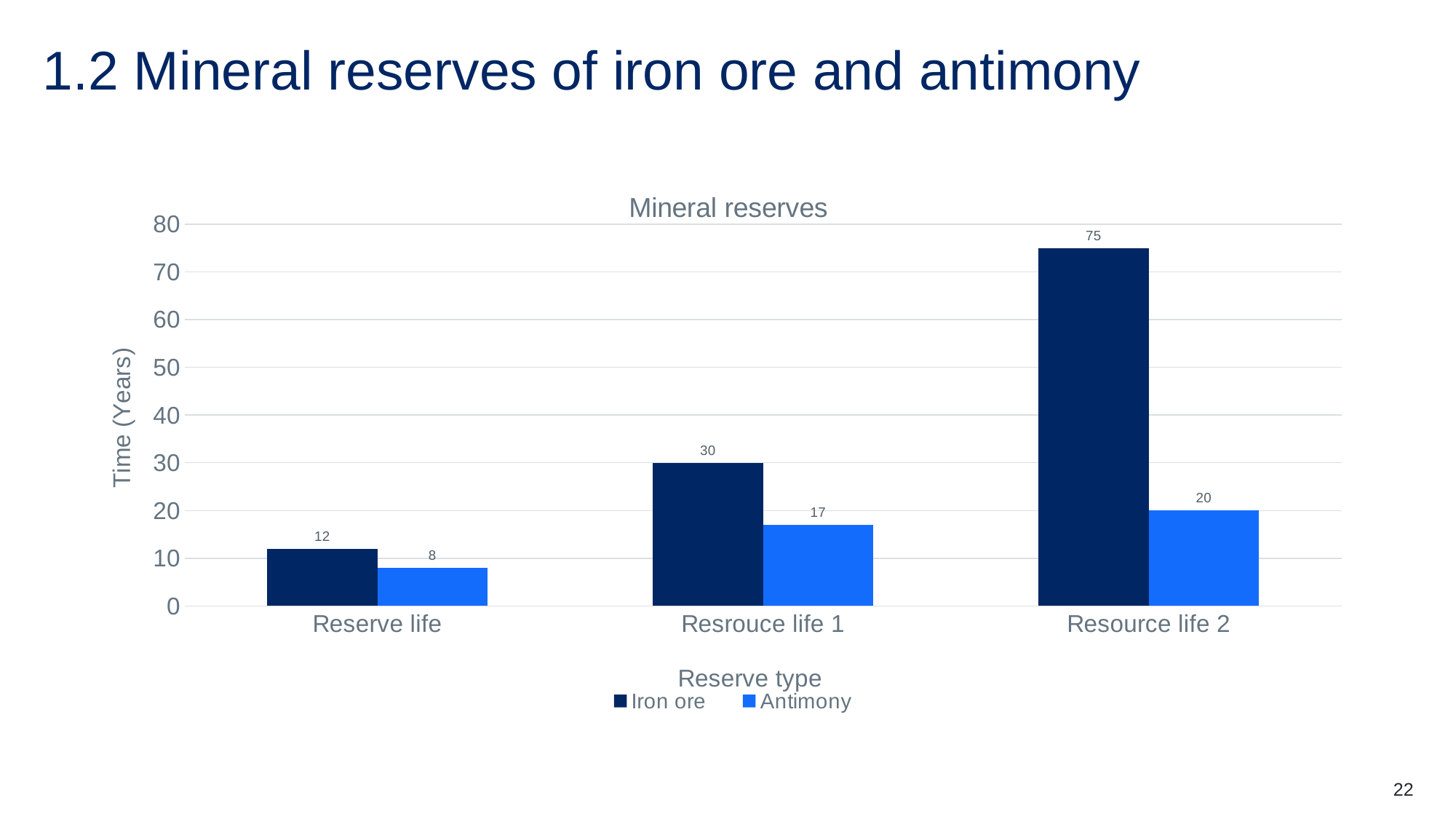
Which category has the lowest Antimony value? Reserve life What is the difference between the Iron ore and Antimony values for Resource life 2? 55 What is the Iron ore value for Reserve life? 12 Which is larger for Resrouce life 1, Iron ore or Antimony? Iron ore Which category has the highest Iron ore value? Resource life 2 How many categories are shown on the x axis? 3 What kind of chart is shown on the slide? Bar chart How many series does the legend list? 2 What is the Antimony value for Reserve life? 8 What is the title of the chart? Mineral reserves What is the Iron ore value for Resource life 2? 75 What is the Antimony value for Resrouce life 1? 17